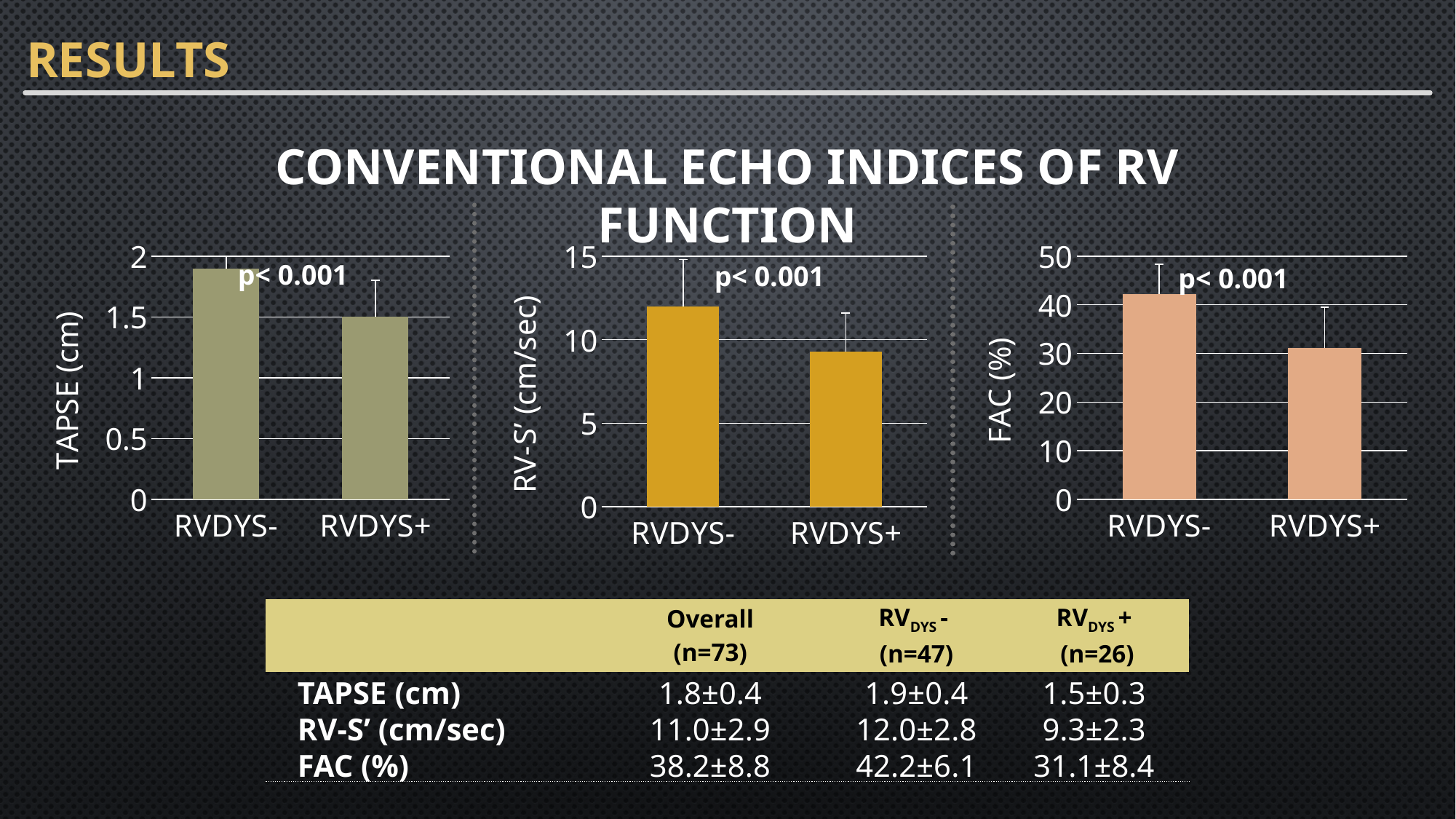
In the RV-S' (cm/sec) chart, is the value for RVDYS+ greater or less than 10? less How many categories are shown on the x axis of the FAC (%) chart? 2 In the RV-S' (cm/sec) chart, is the value for RVDYS- greater or less than 10? greater In the FAC (%) chart, is the value for RVDYS+ greater or less than 40? less In the TAPSE (cm) chart, what is the value for RVDYS+? 1.5 In the RV-S' (cm/sec) chart, which category has the lowest bar? RVDYS+ What kind of chart is the TAPSE (cm) chart on the left? bar chart What p-value is printed on the RV-S' (cm/sec) chart? p< 0.001 In the FAC (%) chart, which category has the highest bar? RVDYS- In the TAPSE (cm) chart, which category has the higher bar, RVDYS- or RVDYS+? RVDYS-